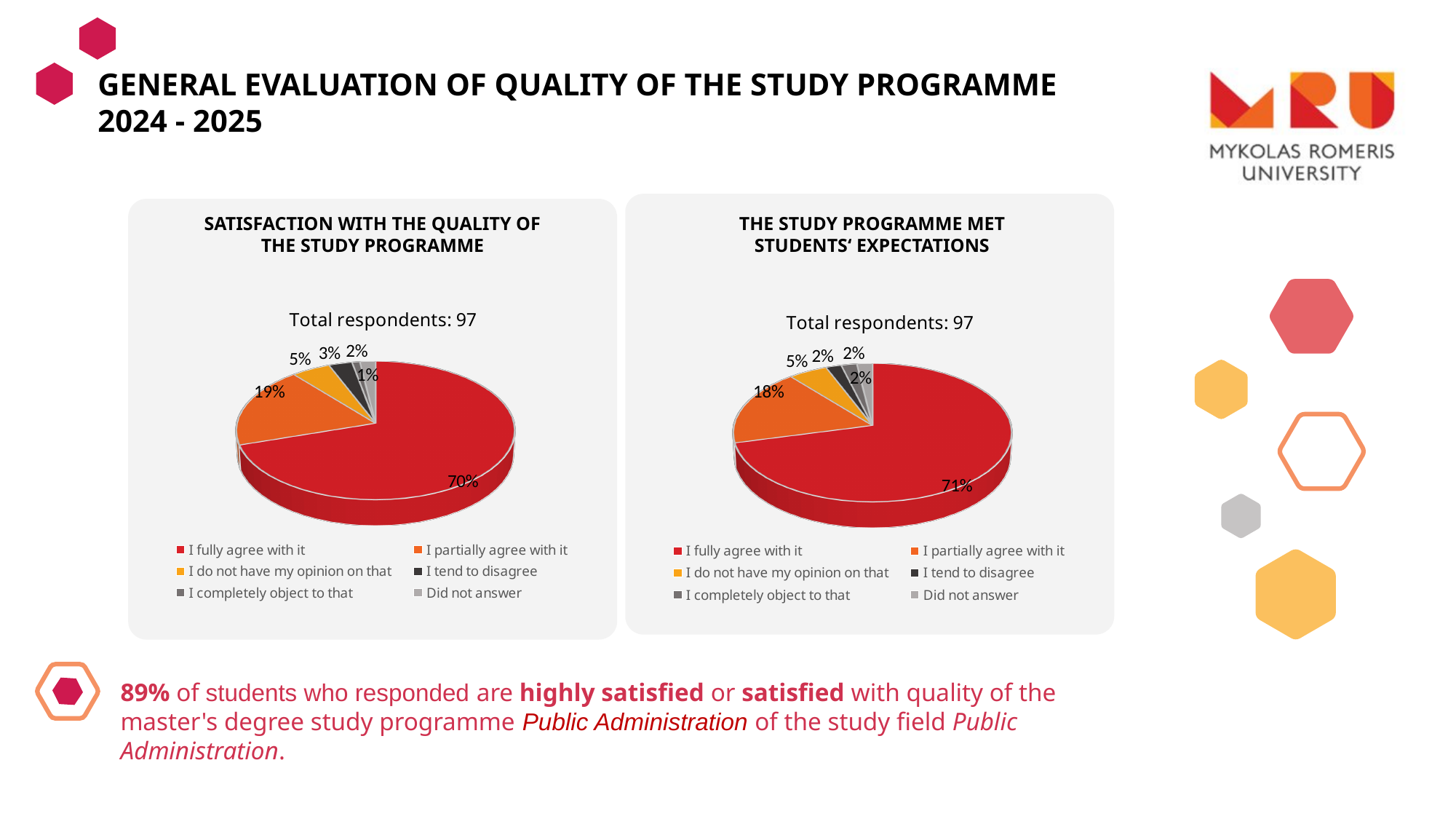
In the chart titled 'The study programme met students' expectations', what share of respondents chose 'I fully agree with it'? 71% In the chart titled 'Satisfaction with the quality of the study programme', which response has the smallest slice? I completely object to that How many response categories does the legend of the 'The study programme met students' expectations' chart list? 6 In the chart titled 'The study programme met students' expectations', what share of respondents chose 'I partially agree with it'? 18% In the chart titled 'Satisfaction with the quality of the study programme', which response has the largest slice? I fully agree with it In the chart titled 'Satisfaction with the quality of the study programme', what share of respondents chose 'I partially agree with it'? 19% In the chart titled 'Satisfaction with the quality of the study programme', what is the difference between the 'I fully agree with it' and 'I partially agree with it' shares? 51% In the chart titled 'Satisfaction with the quality of the study programme', what share of respondents chose 'I fully agree with it'? 70% How many total respondents are reported for the 'Satisfaction with the quality of the study programme' chart? 97 In the chart titled 'The study programme met students' expectations', what is the difference between the 'I fully agree with it' and 'I partially agree with it' shares? 53% What type of chart is used in the 'Satisfaction with the quality of the study programme' panel? Pie chart Which chart has the larger 'I fully agree with it' share: 'Satisfaction with the quality of the study programme' or 'The study programme met students' expectations'? The study programme met students' expectations